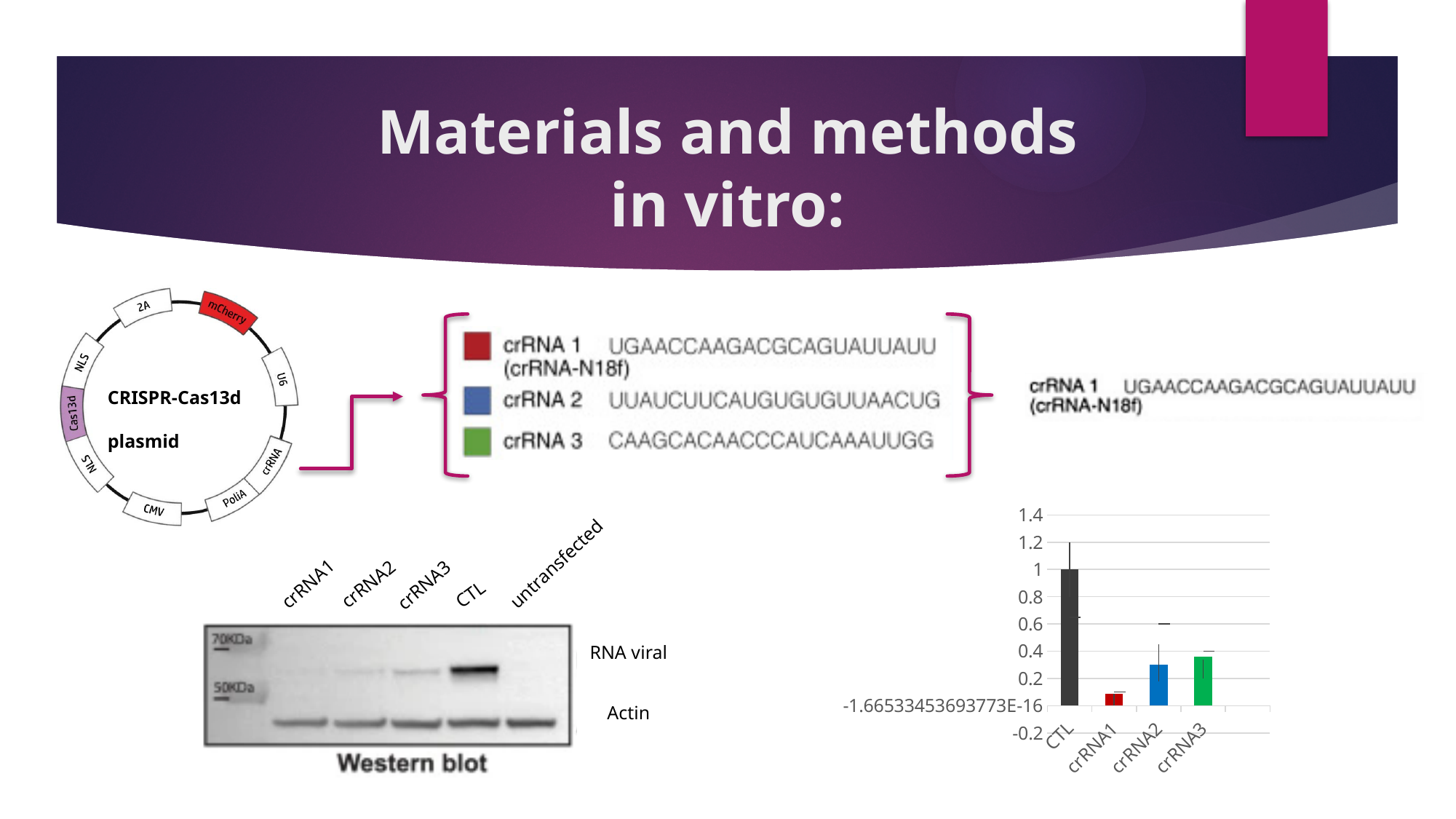
In the bar chart at the bottom right, is the value for crRNA1 greater or less than 0.2? less What kind of chart is shown at the bottom right of the slide? bar chart How many categories are plotted on the bar chart at the bottom right? 4 In the bar chart at the bottom right, what is the highest value labelled on the vertical axis? 1.4 In the bar chart at the bottom right, which category has the highest value? CTL In the bar chart at the bottom right, is the value for crRNA3 greater or less than 0.2? greater In the bar chart at the bottom right, which category has the lowest value? crRNA1 In the bar chart at the bottom right, is the value for crRNA2 greater or less than 0.4? less In the bar chart at the bottom right, what is the value for CTL? 1 In the bar chart at the bottom right, which is larger, the value for CTL or the value for crRNA2? CTL In the bar chart at the bottom right, what colour is the crRNA3 bar? green